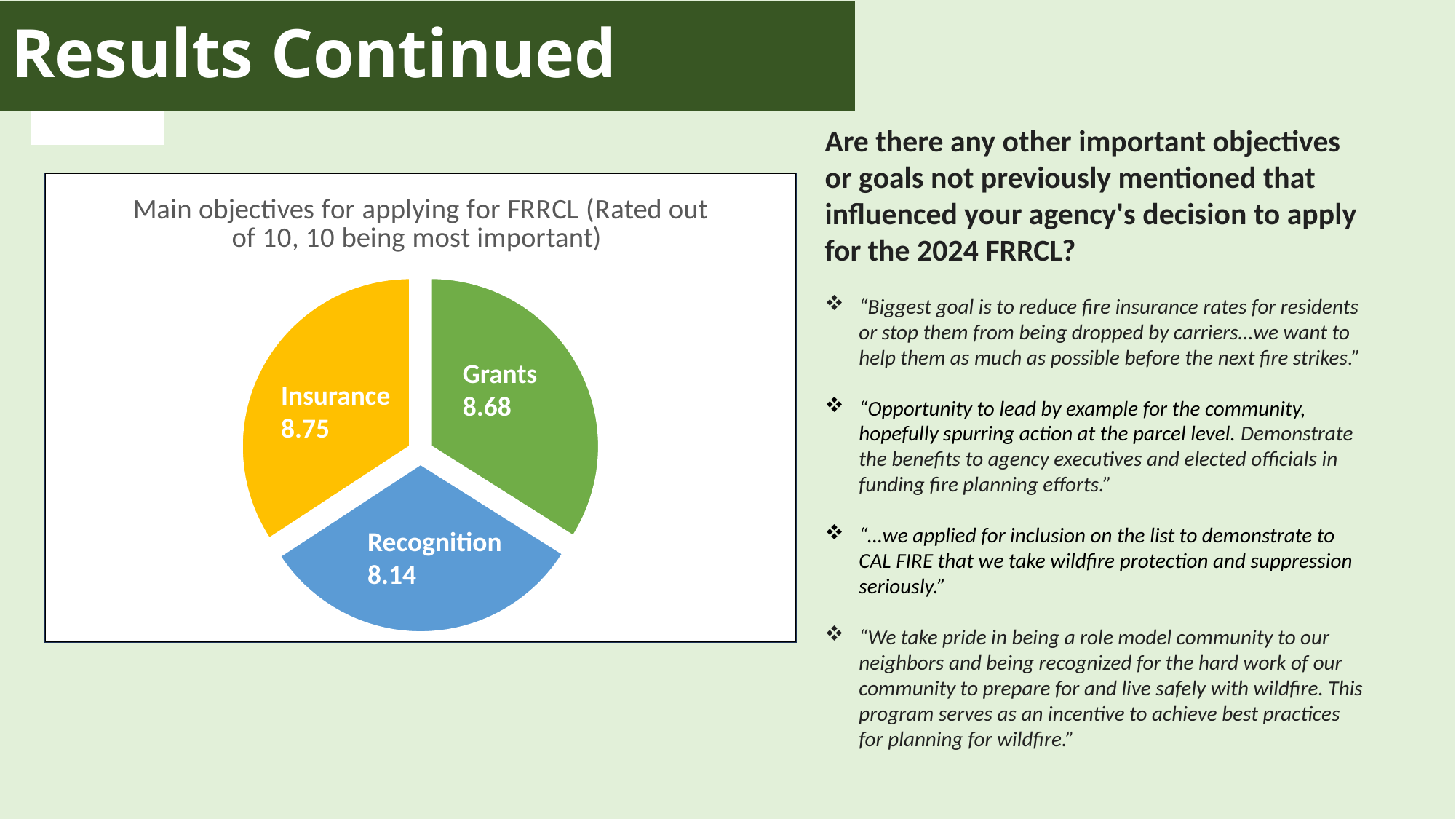
How many slices does the pie chart have? 3 What is the rating for Recognition in the pie chart? 8.14 What is the rating for Insurance in the pie chart? 8.75 What colour is the Recognition slice in the pie chart? blue What is the rating for Grants in the pie chart? 8.68 What is the difference between the Insurance rating and the Recognition rating? 0.61 Which is rated higher, Grants or Recognition? Grants What is the title of the pie chart? Main objectives for applying for FRRCL (Rated out of 10, 10 being most important) What is the difference between the Grants rating and the Recognition rating? 0.54 What type of chart is shown on the slide? pie chart Which objective has the lowest rating in the pie chart? Recognition Which objective has the highest rating in the pie chart? Insurance